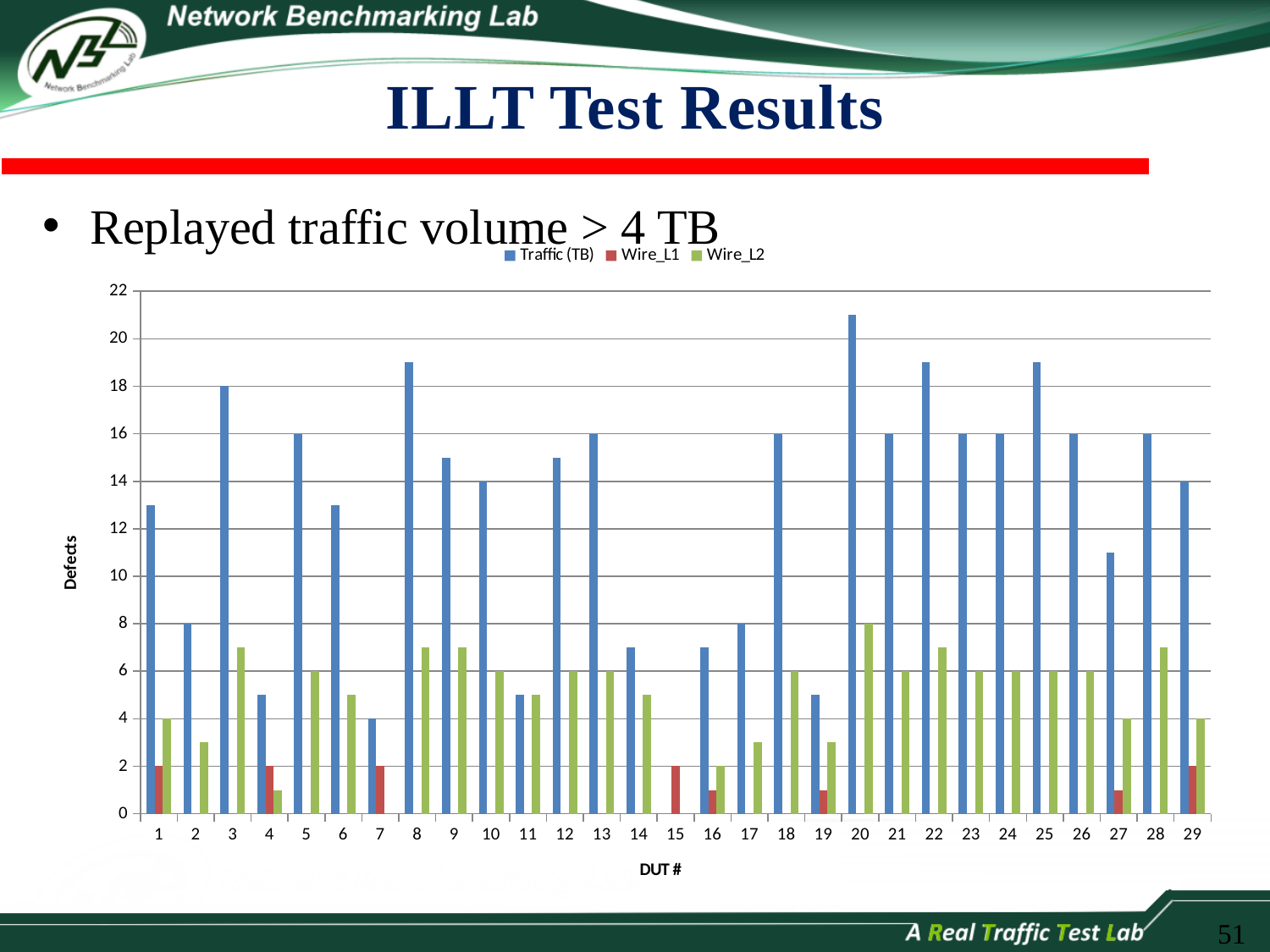
How many DUTs are shown along the x axis of the chart? 29 What type of chart is shown on the slide? bar chart What is the Traffic (TB) value for DUT 2? 8 Is the Traffic (TB) value for DUT 20 greater or less than 18? greater What is the difference between the Traffic (TB) values for DUT 3 and DUT 2? 10 What is the title of the chart's y axis? Defects How many series does the chart legend list? 3 Which is larger, the Traffic (TB) value for DUT 5 or for DUT 10? DUT 5 What is the Traffic (TB) value for DUT 3? 18 Is the Traffic (TB) value for DUT 7 greater or less than 10? less What is the Wire_L2 value for DUT 20? 8 Which DUT has the highest Traffic (TB) value? 20